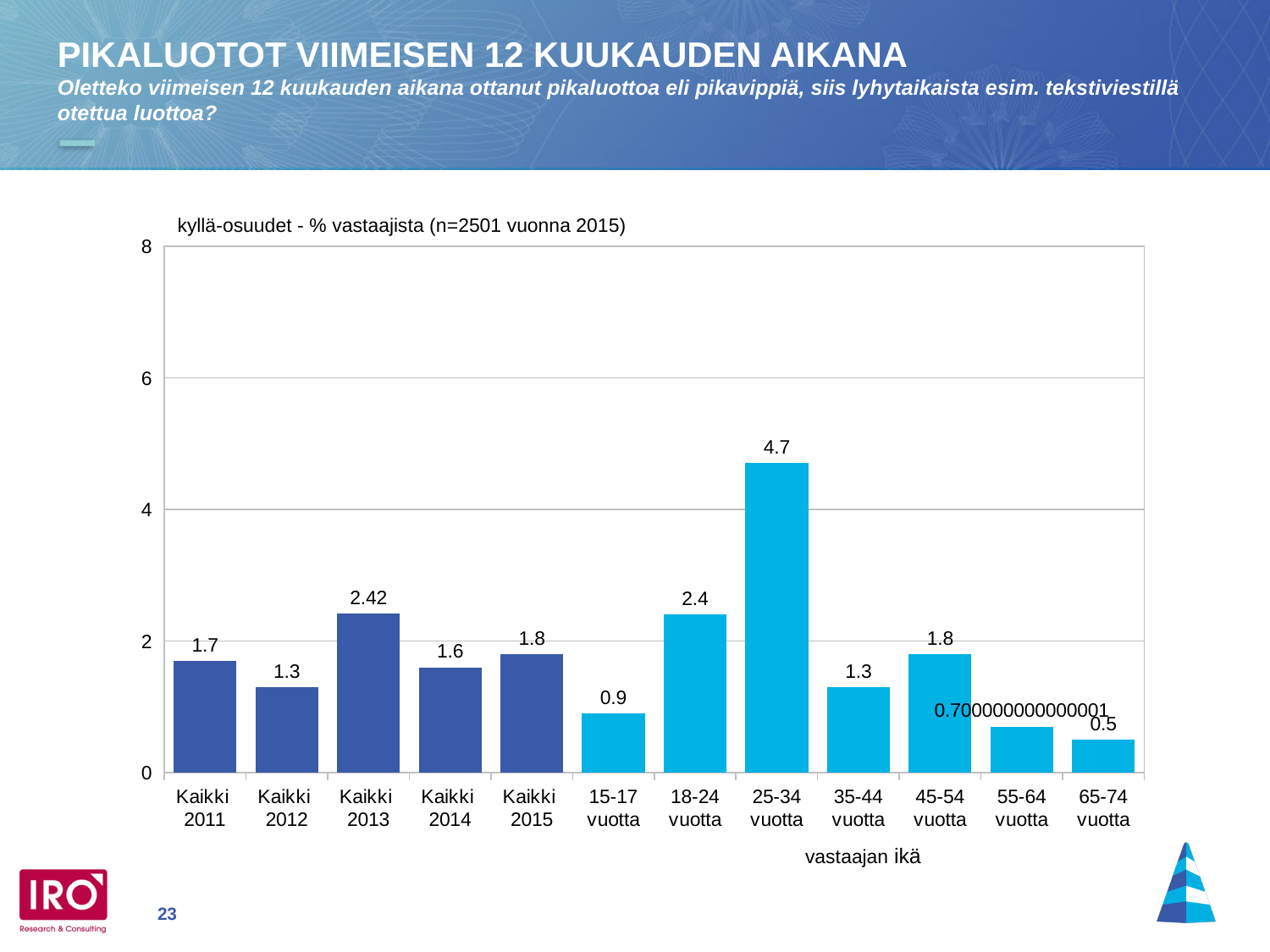
What is the difference between the values for 25-34 vuotta and 18-24 vuotta? 2.3 Is the value for 25-34 vuotta greater or less than 4? greater Which is larger, the value for Kaikki 2011 or Kaikki 2012? Kaikki 2011 What is the value for the 25-34 vuotta age group? 4.7 What is the value for Kaikki 2015? 1.8 What kind of chart is shown on the slide? bar chart Which category has the highest value? 25-34 vuotta How many categories are shown on the x axis? 12 Which category has the lowest value? 65-74 vuotta What is the value for Kaikki 2013? 2.42 What is the x-axis title of the chart? vastaajan ikä What is the value for the 15-17 vuotta age group? 0.9